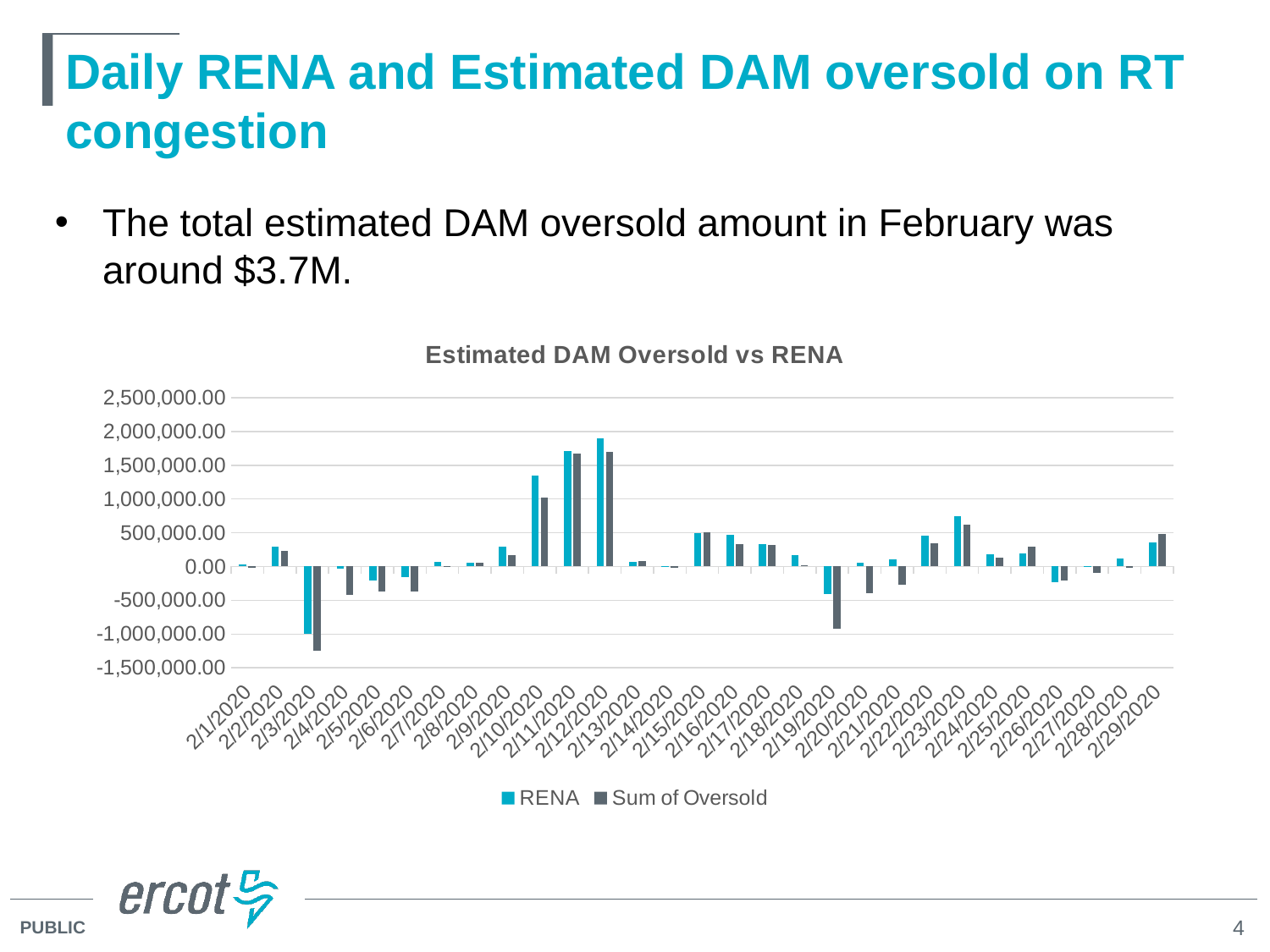
How many dates are shown on the x axis of the chart? 29 On which date is the Sum of Oversold value lowest? 2/3/2020 On which date is the RENA value highest? 2/12/2020 Is the Sum of Oversold value for 2/20/2020 greater or less than -500,000.00? greater Is the Sum of Oversold value for 2/3/2020 greater or less than -1,000,000.00? less On which date is the RENA value lowest? 2/3/2020 Is the RENA value for 2/12/2020 greater or less than 1,500,000.00? greater What type of chart is shown on the slide? Bar chart What is the title of the chart? Estimated DAM Oversold vs RENA On 2/10/2020, which is larger: the RENA value or the Sum of Oversold value? RENA How many series does the chart legend list? 2 Which series is shown in gray in the chart? Sum of Oversold